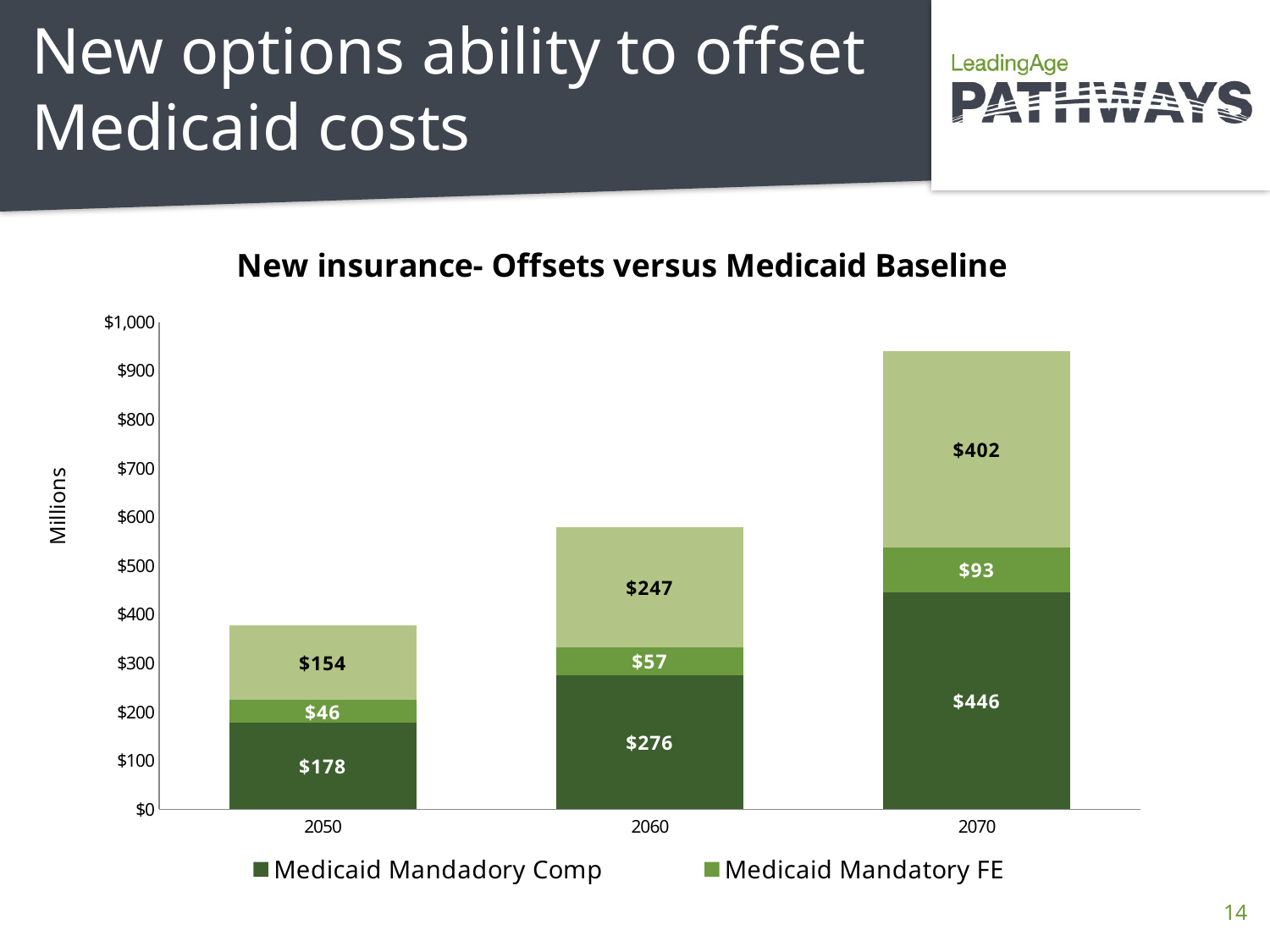
What is the value for Medicaid Mandadory Comp in 2060? $276 In which year is the Medicaid Mandatory FE value highest? 2070 Which is larger: Medicaid Mandatory FE in 2060 or Medicaid Mandatory FE in 2070? Medicaid Mandatory FE in 2070 In which year is the Medicaid Mandadory Comp value lowest? 2050 What is the value for Medicaid Mandatory FE in 2050? $46 What is the value of the light green top segment of the 2060 bar? $247 What is the total of the stacked bar for 2070? $941 How many years are shown on the x axis? 3 What is the total of the stacked bar for 2050? $378 What is the value for Medicaid Mandadory Comp in 2070? $446 What is the title of the chart? New insurance- Offsets versus Medicaid Baseline What is the difference between the Medicaid Mandadory Comp values for 2070 and 2050? $268